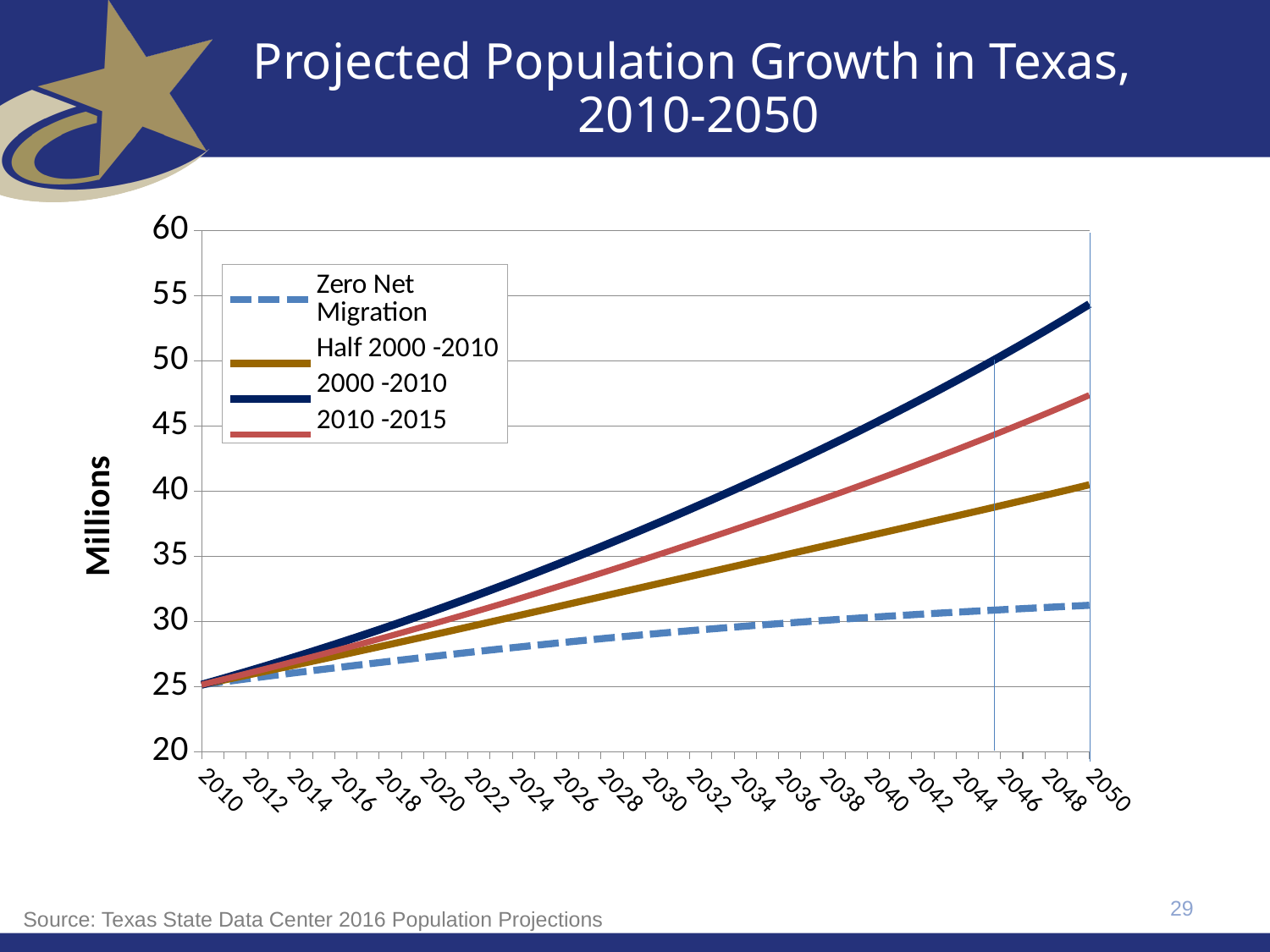
Which series has the highest value in 2050? 2000 -2010 What kind of chart is shown on the slide? line chart Do the values of the 2000 -2010 series rise or fall from 2010 to 2050? rise In 2050, which is larger: the 2010 -2015 series or the Half 2000 -2010 series? 2010 -2015 How many series does the legend list? 4 What is the label on the vertical axis? Millions Which series has the lowest value in 2050? Zero Net Migration Is the value for the 2010 -2015 series in 2050 greater or less than 45? greater What is the title of the chart? Projected Population Growth in Texas, 2010-2050 Is the value for the 2000 -2010 series in 2050 greater or less than 50? greater Is the value for the Zero Net Migration series in 2050 greater or less than 35? less